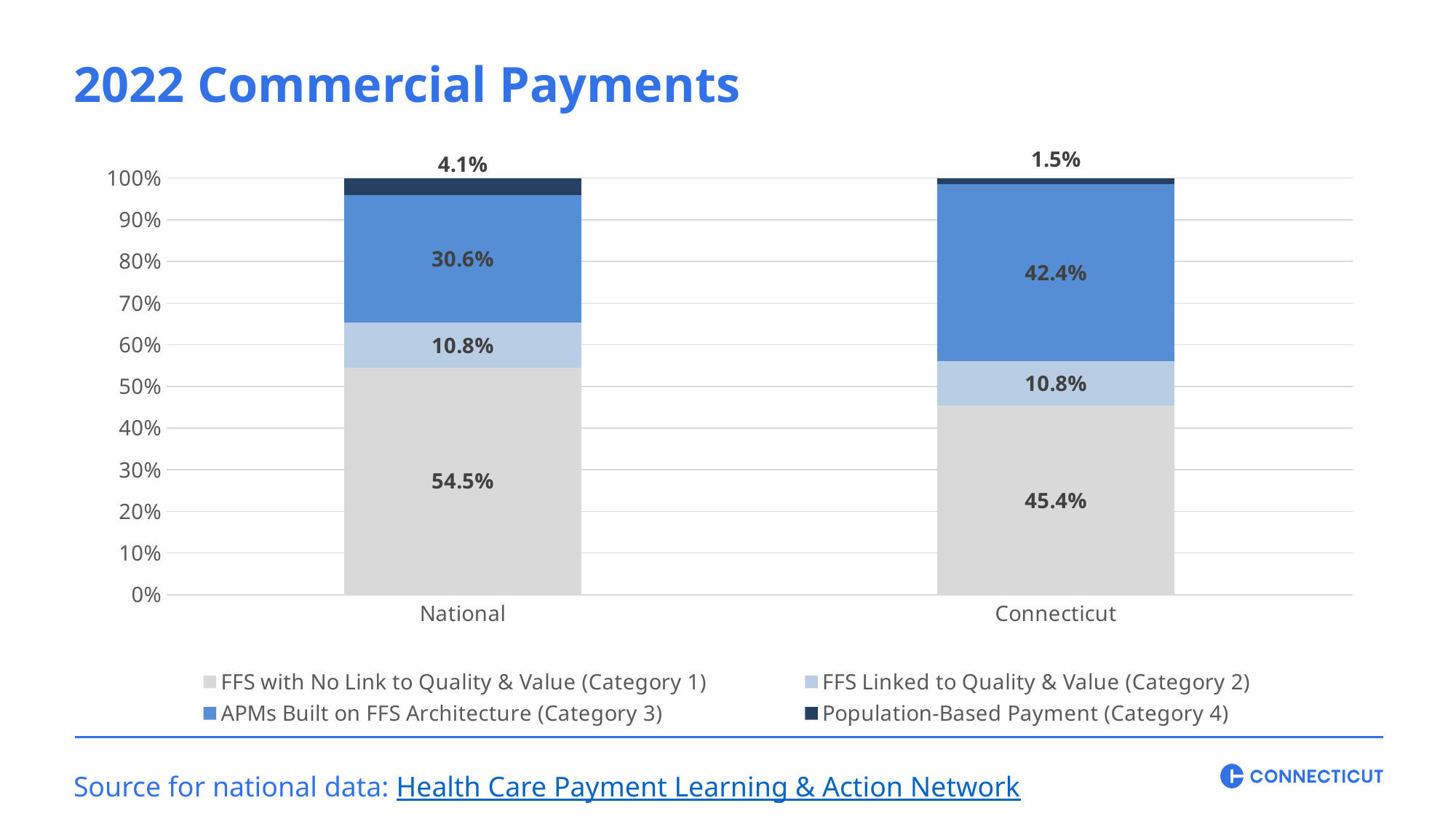
How many series does the legend list? 4 What is the difference between the Connecticut and National values for APMs Built on FFS Architecture (Category 3)? 11.8% What is the value for FFS Linked to Quality & Value (Category 2) for Connecticut? 10.8% What is the difference between the National and Connecticut values for FFS with No Link to Quality & Value (Category 1)? 9.1% What is the value for Population-Based Payment (Category 4) for National? 4.1% What kind of chart is shown on the slide? Stacked bar chart Which series has the largest value in the Connecticut bar? FFS with No Link to Quality & Value (Category 1) Which category has the larger share of Population-Based Payment (Category 4), National or Connecticut? National Which series has the smallest value in the National bar? Population-Based Payment (Category 4) How many categories are shown on the x axis? 2 What is the value for APMs Built on FFS Architecture (Category 3) for Connecticut? 42.4% What is the value for FFS with No Link to Quality & Value (Category 1) for National? 54.5%